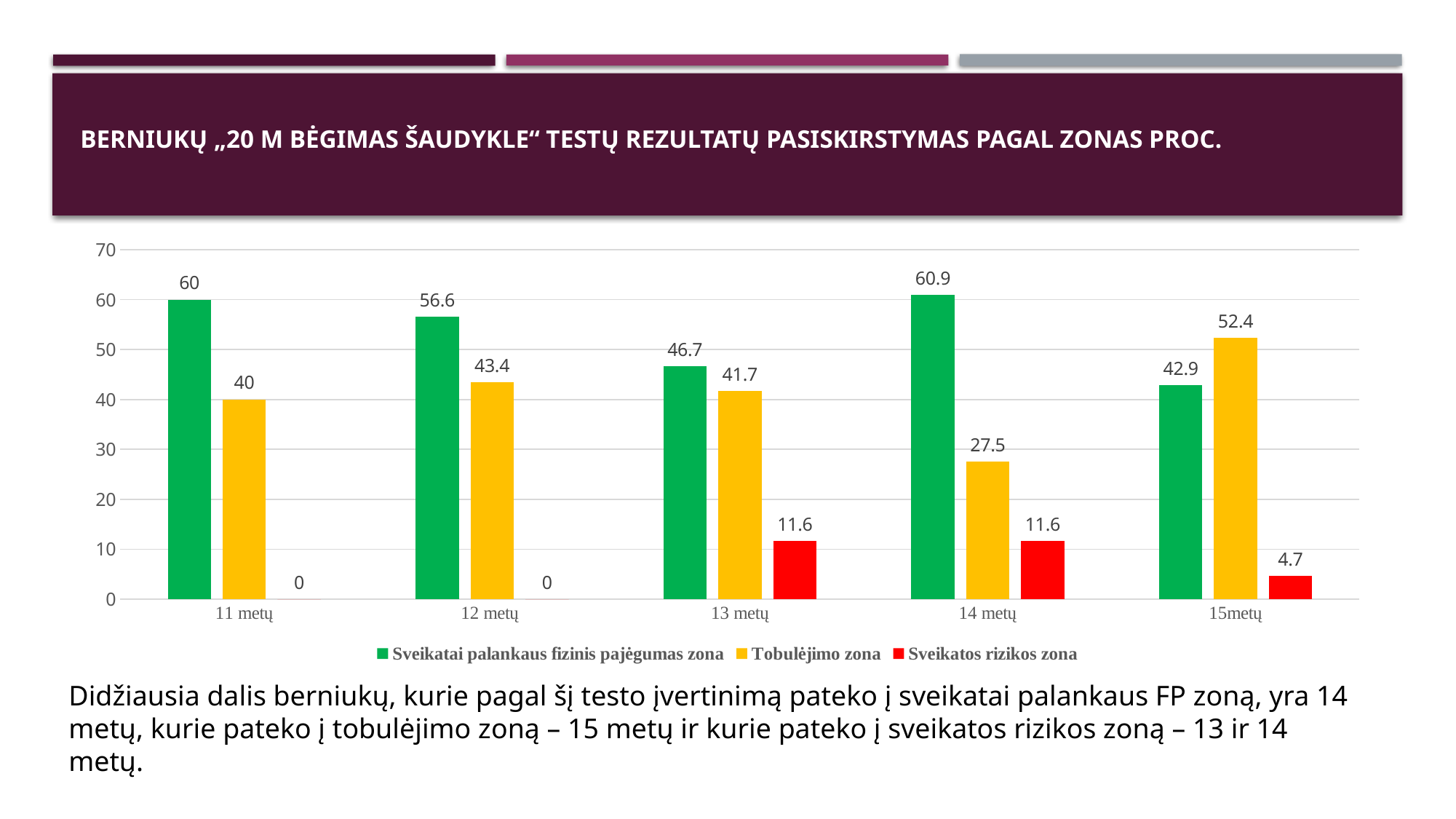
What is the value for 'Sveikatos rizikos zona' at 13 metų? 11.6 At 15metų, which is larger: 'Sveikatai palankaus fizinis pajėgumas zona' or 'Tobulėjimo zona'? Tobulėjimo zona What kind of chart is shown on the slide? bar chart What is the difference between the 'Sveikatai palankaus fizinis pajėgumas zona' and 'Tobulėjimo zona' values at 12 metų? 13.2 Which age group has the highest value for 'Sveikatai palankaus fizinis pajėgumas zona'? 14 metų What colour represents 'Sveikatos rizikos zona' in the chart? red Is the value for 'Sveikatai palankaus fizinis pajėgumas zona' at 13 metų greater or less than 50? less Which age group has the lowest value for 'Tobulėjimo zona'? 14 metų What is the value for 'Sveikatai palankaus fizinis pajėgumas zona' at 11 metų? 60 How many age groups are shown on the x axis? 5 What is the value for 'Tobulėjimo zona' at 15metų? 52.4 How many series does the legend list? 3